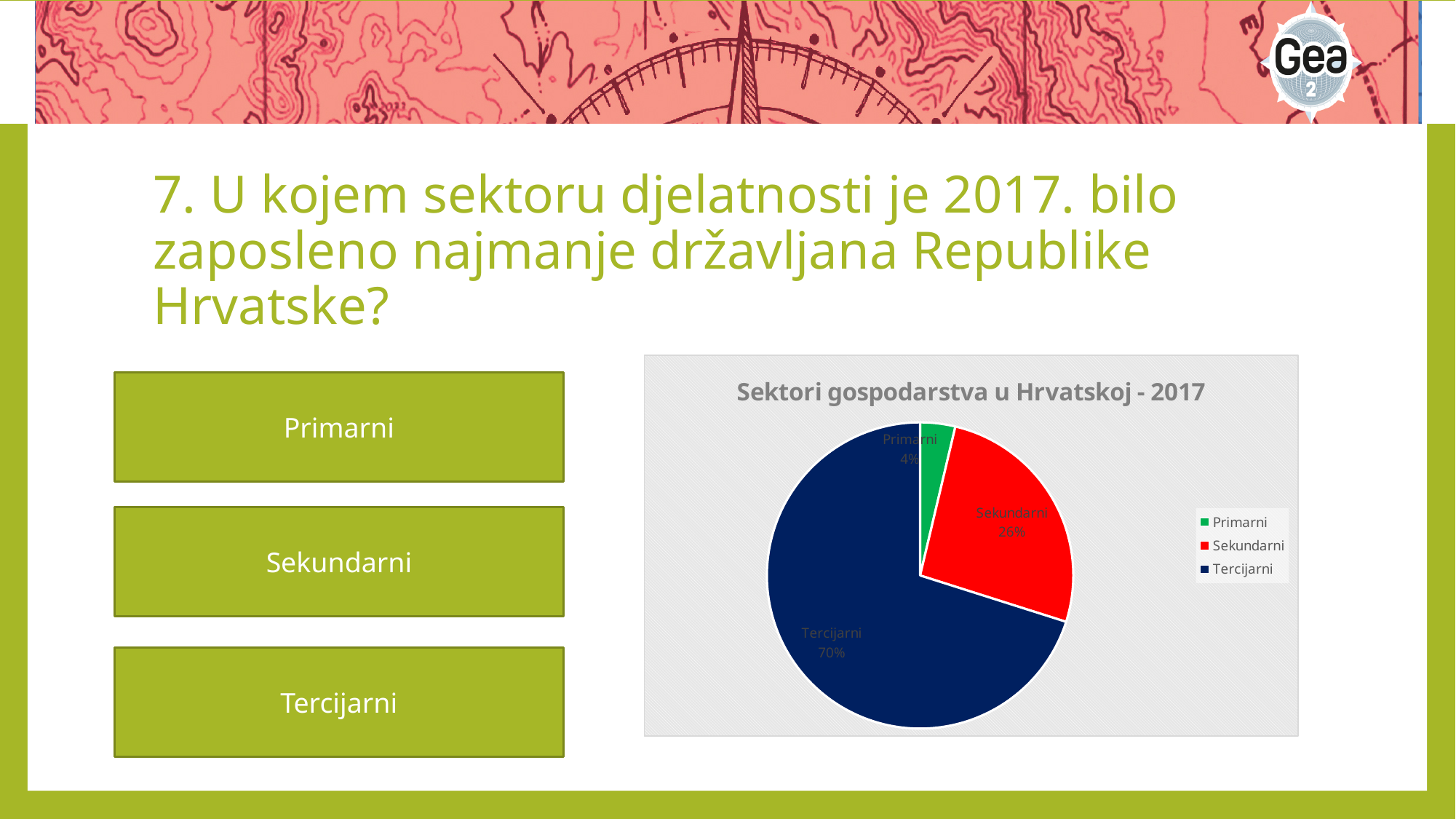
Which sector has the smallest share of the pie? Primarni What share of the pie does the Tercijarni sector have? 70% What kind of chart is shown on the slide? pie chart How many slices does the pie chart have? 3 What is the title of the chart? Sektori gospodarstva u Hrvatskoj - 2017 What colour is the Sekundarni slice? red What share of the pie does the Primarni sector have? 4% Which is larger, the Sekundarni share or the Primarni share? Sekundarni How many entries does the legend list? 3 What is the difference in percentage points between the Tercijarni and Sekundarni shares? 44 What share of the pie does the Sekundarni sector have? 26% Which sector has the largest share of the pie? Tercijarni